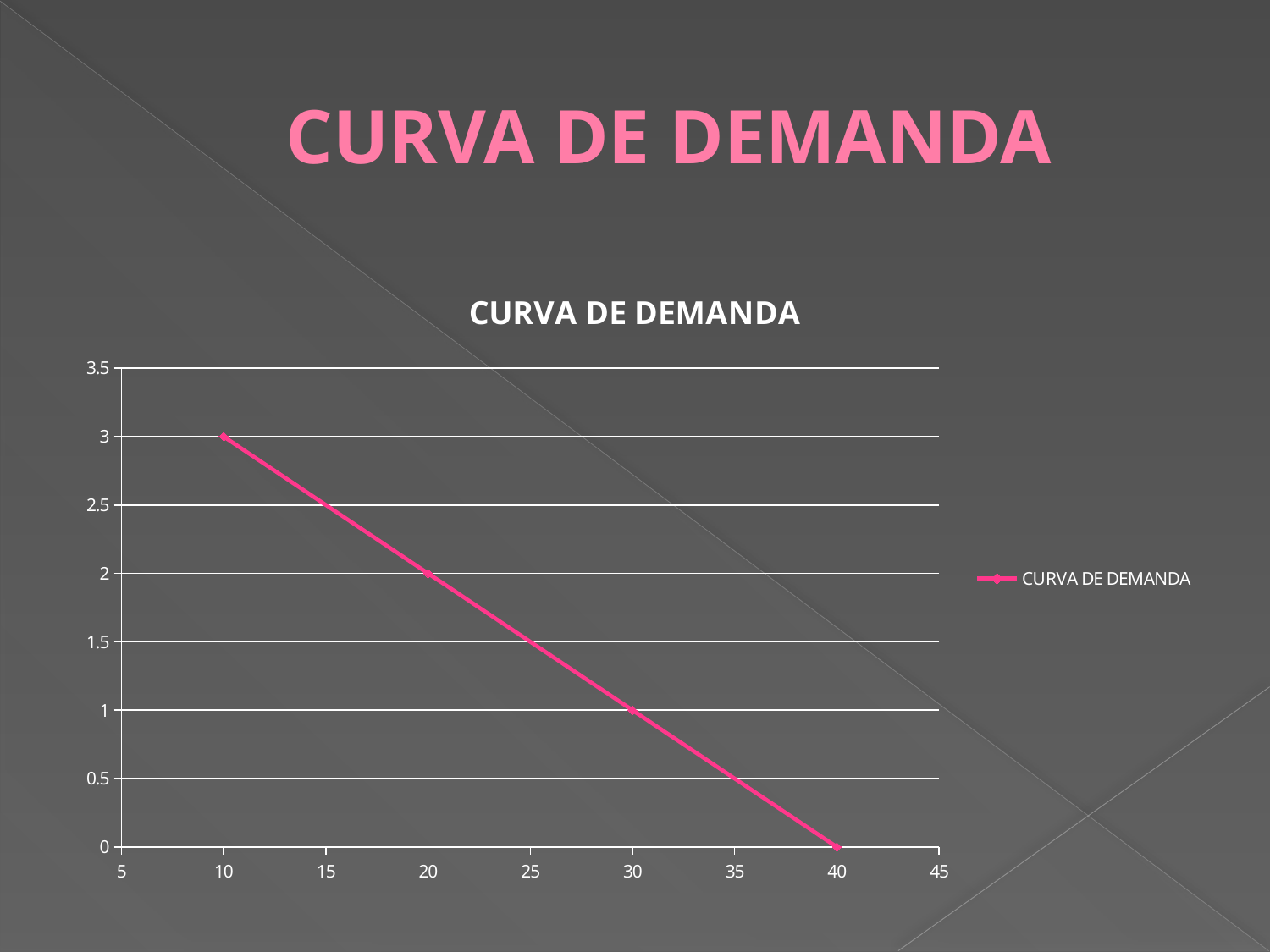
What is the difference between the y value at x = 10 and the y value at x = 30? 2 How many series does the legend list? 1 What is the y value of the point at x = 30? 1 At which x value is the y value lowest? 40 What is the y value of the point at x = 40? 0 At which x value is the y value highest? 10 Do the values rise or fall as x increases along the x axis? fall What is the y value of the point at x = 20? 2 What type of chart is shown on the slide? line chart What is the y value of the point at x = 10? 3 How many data points are plotted on the line? 4 What is the title of the chart? CURVA DE DEMANDA